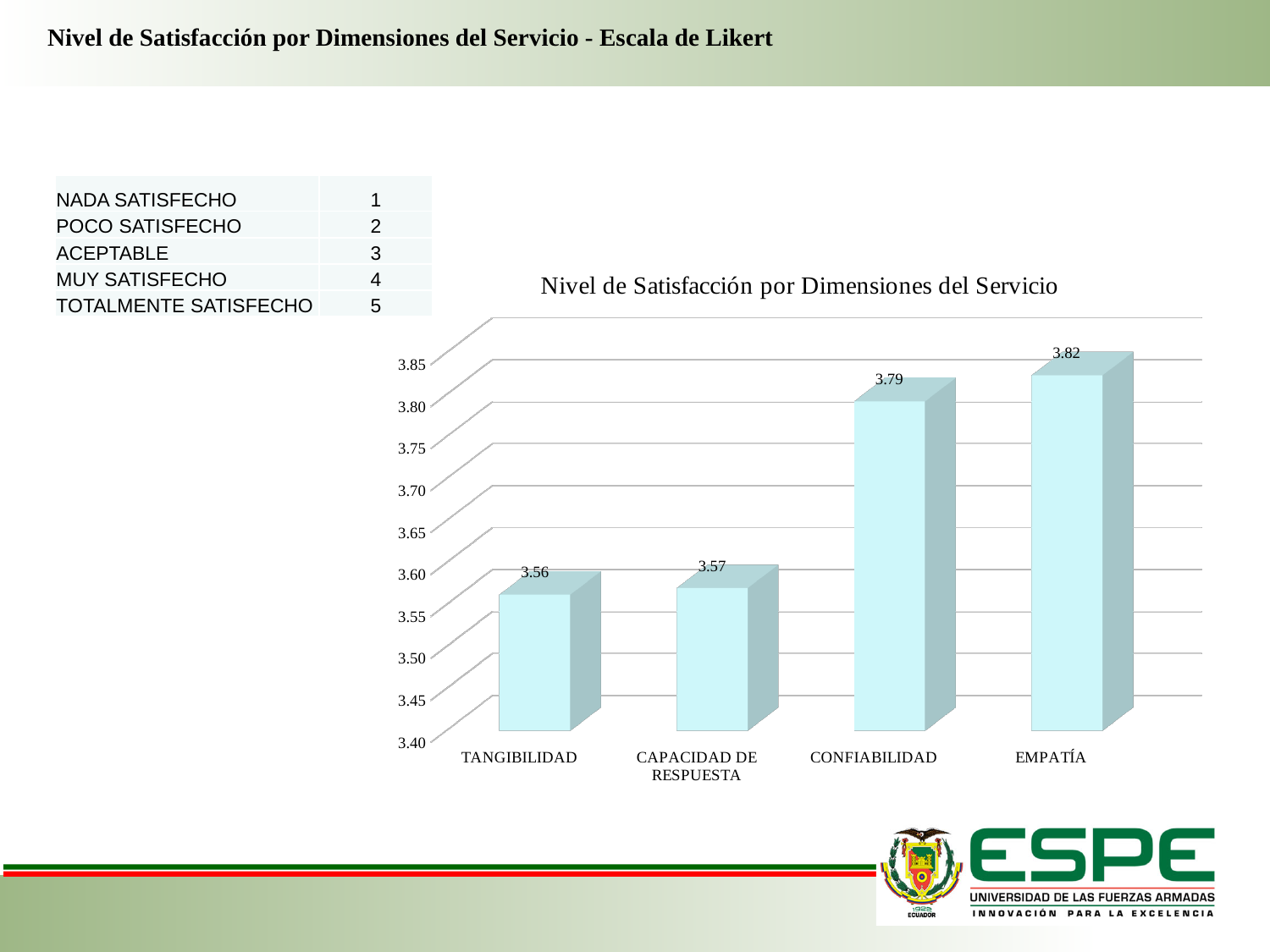
How many dimensions are shown on the x axis of the chart? 4 What is the value for CAPACIDAD DE RESPUESTA? 3.57 What is the value for CONFIABILIDAD? 3.79 Which dimension has the lowest satisfaction value? TANGIBILIDAD What is the difference between the values for CONFIABILIDAD and CAPACIDAD DE RESPUESTA? 0.22 What is the value for TANGIBILIDAD? 3.56 What is the difference between the values for EMPATÍA and TANGIBILIDAD? 0.26 Which is larger, the value for CONFIABILIDAD or the value for TANGIBILIDAD? CONFIABILIDAD What is the value for EMPATÍA? 3.82 Which dimension has the highest satisfaction value? EMPATÍA What is the title of the chart? Nivel de Satisfacción por Dimensiones del Servicio What kind of chart is shown on the slide? Bar chart